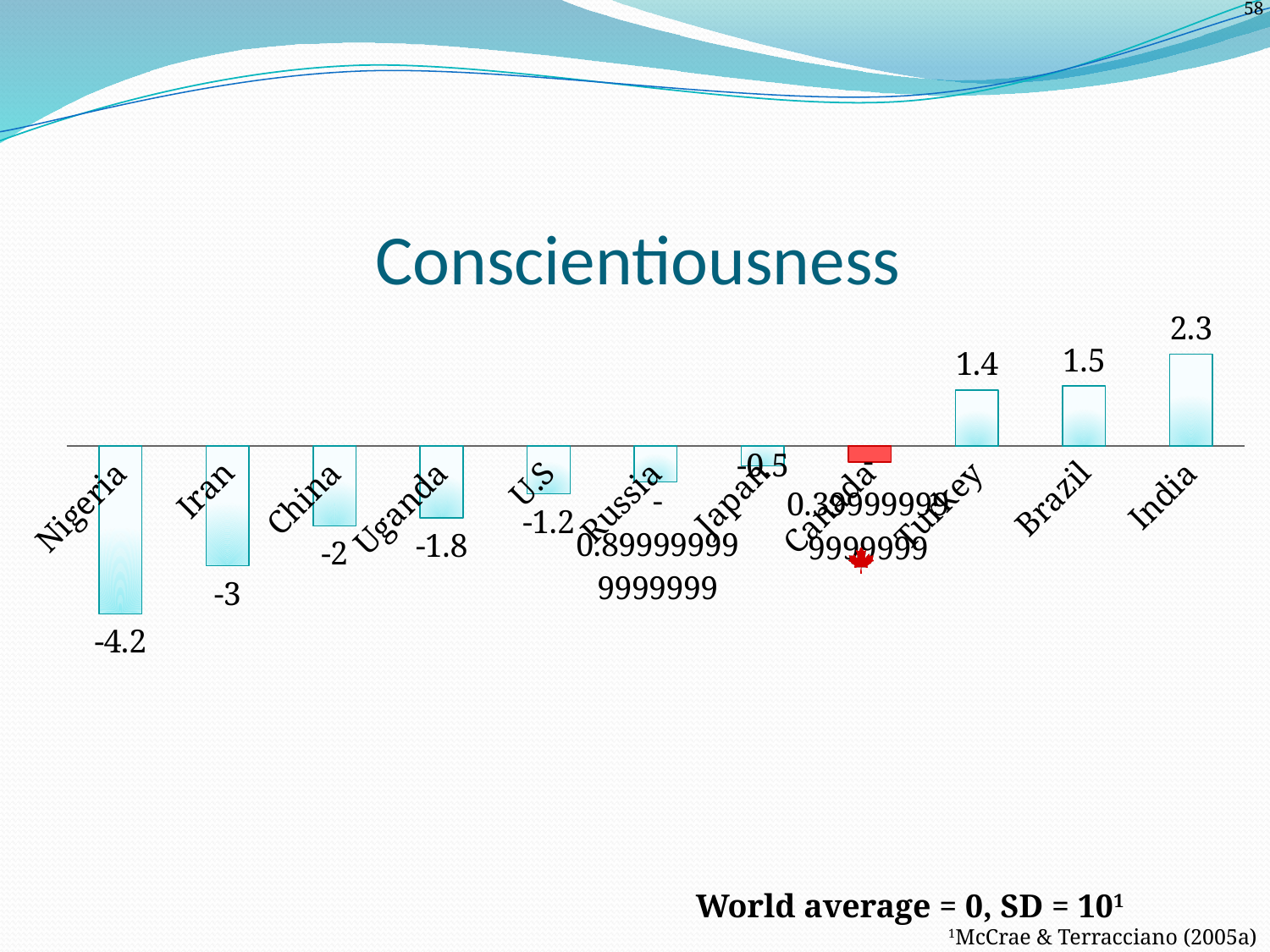
Which country has the lowest value? Nigeria Which is larger, the value for China or the value for Uganda? Uganda How many countries are shown in the chart? 11 Which country has the highest value? India What is the title of the chart? Conscientiousness What is the difference between the values for Iran and Nigeria? 1.2 What is the value for Iran? -3 What is the value for Nigeria? -4.2 What is the value for India? 2.3 What is the difference between the values for India and Brazil? 0.8 What is the value for Turkey? 1.4 What kind of chart is shown on the slide? Bar chart